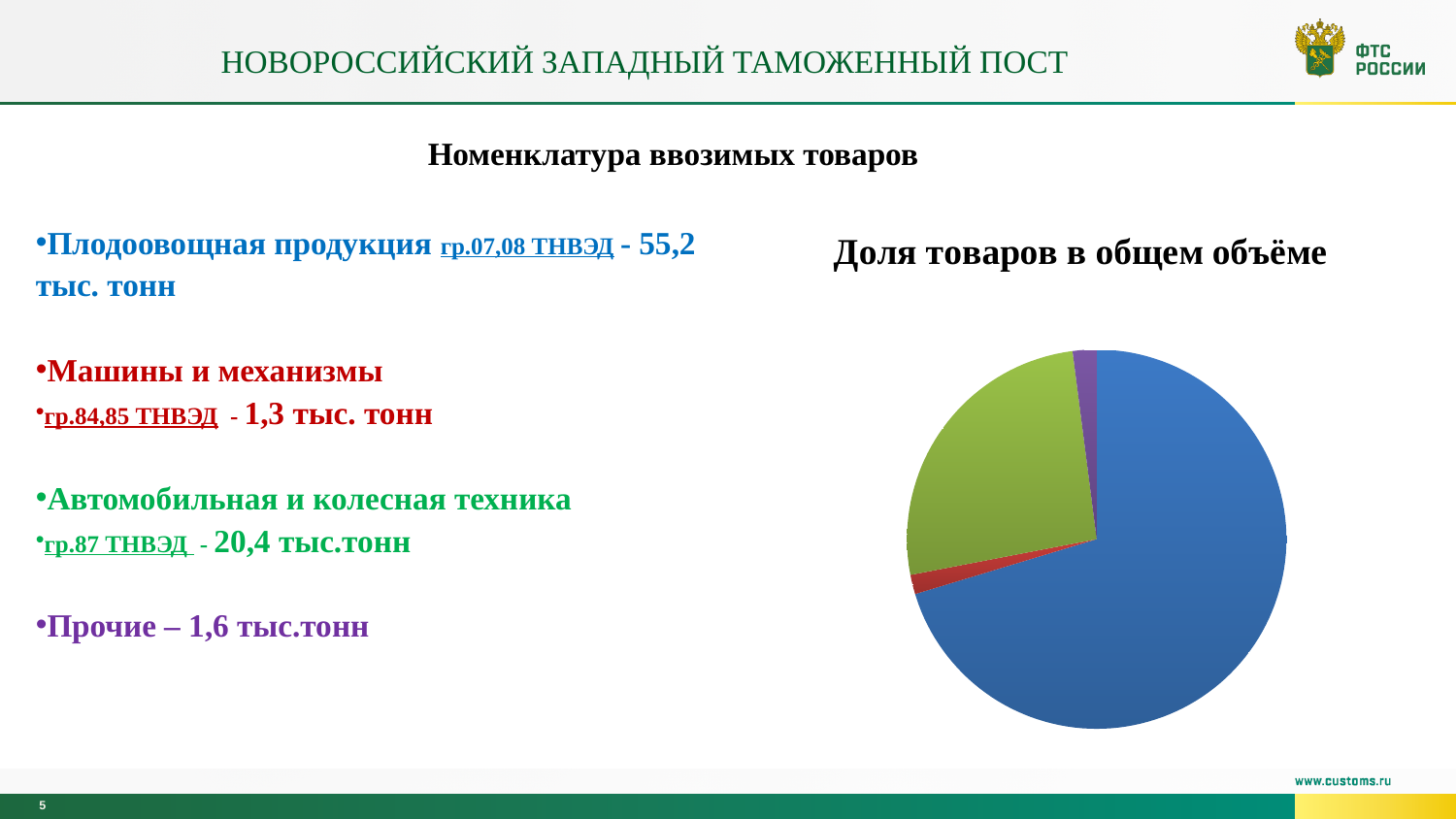
Which product category, according to the colour-matched text on the slide, corresponds to the green slice of the pie? Автомобильная и колесная техника Which product category, according to the colour-matched text on the slide, corresponds to the largest slice of the pie? Плодоовощная продукция How many slices does the pie chart have? 4 Does the pie chart display a legend? no Which is larger in the pie chart, the green slice or the red slice? green Which is larger in the pie chart, the blue slice or the green slice? blue Which colour slice is the largest in the pie chart? blue Does the blue slice take up more or less than half of the pie? more What is the title of the chart on the slide? Доля товаров в общем объёме What kind of chart is shown on the slide? pie chart